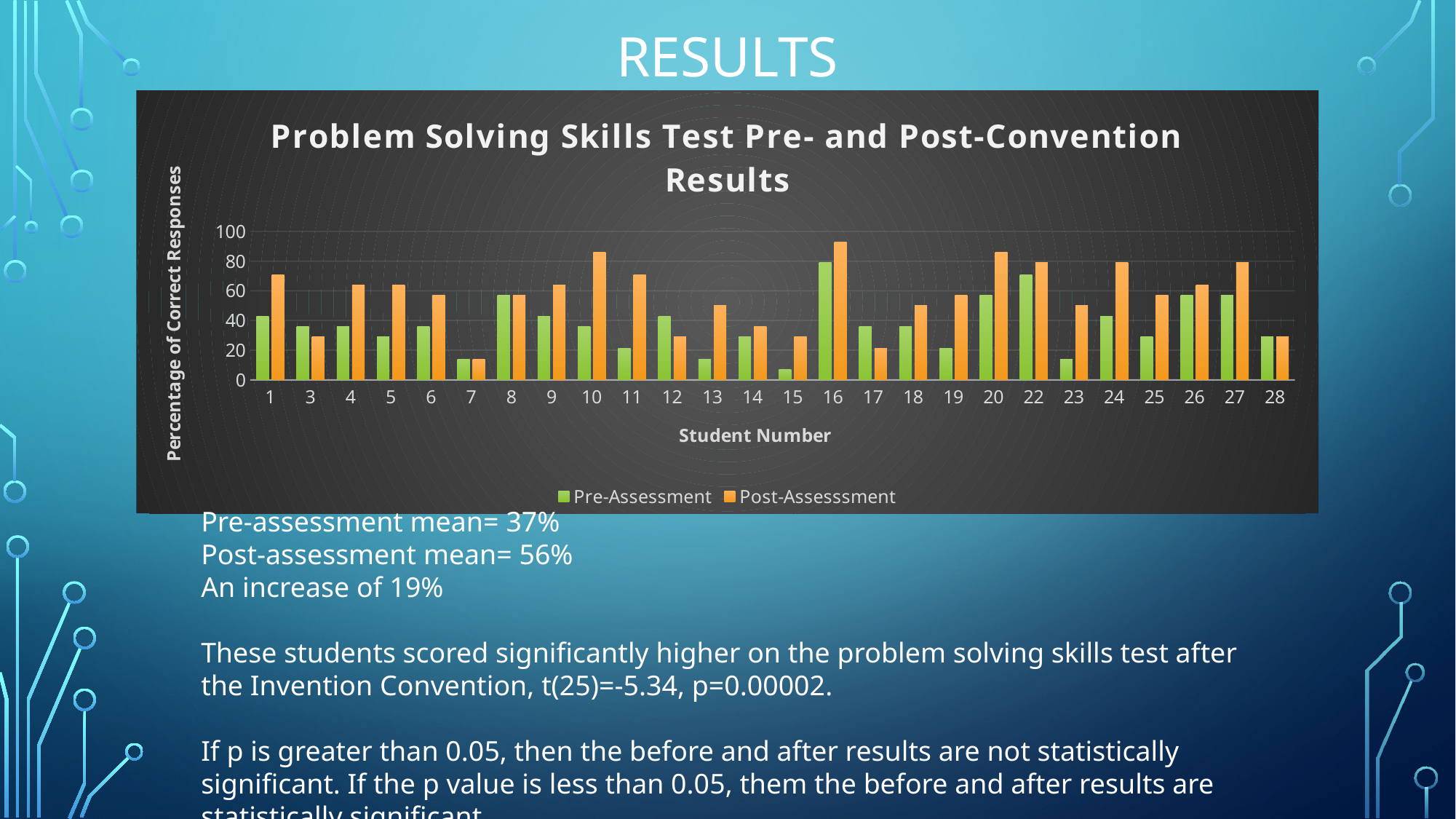
How many student numbers are shown along the x axis of the chart? 26 Which student has the lowest Post-Assessment value? 7 Is the Post-Assessment value for student 16 greater or less than 80? greater For student 1, which is larger: the Pre-Assessment or the Post-Assessment value? Post-Assessment What kind of chart is shown on the slide? bar chart What is the title of the chart? Problem Solving Skills Test Pre- and Post-Convention Results How many series does the chart's legend list? 2 Which student has the highest Post-Assessment value? 16 What is the label on the chart's vertical axis? Percentage of Correct Responses Is the Pre-Assessment value for student 22 greater or less than 60? greater Is the Pre-Assessment value for student 15 greater or less than 20? less Which student has the lowest Pre-Assessment value? 15